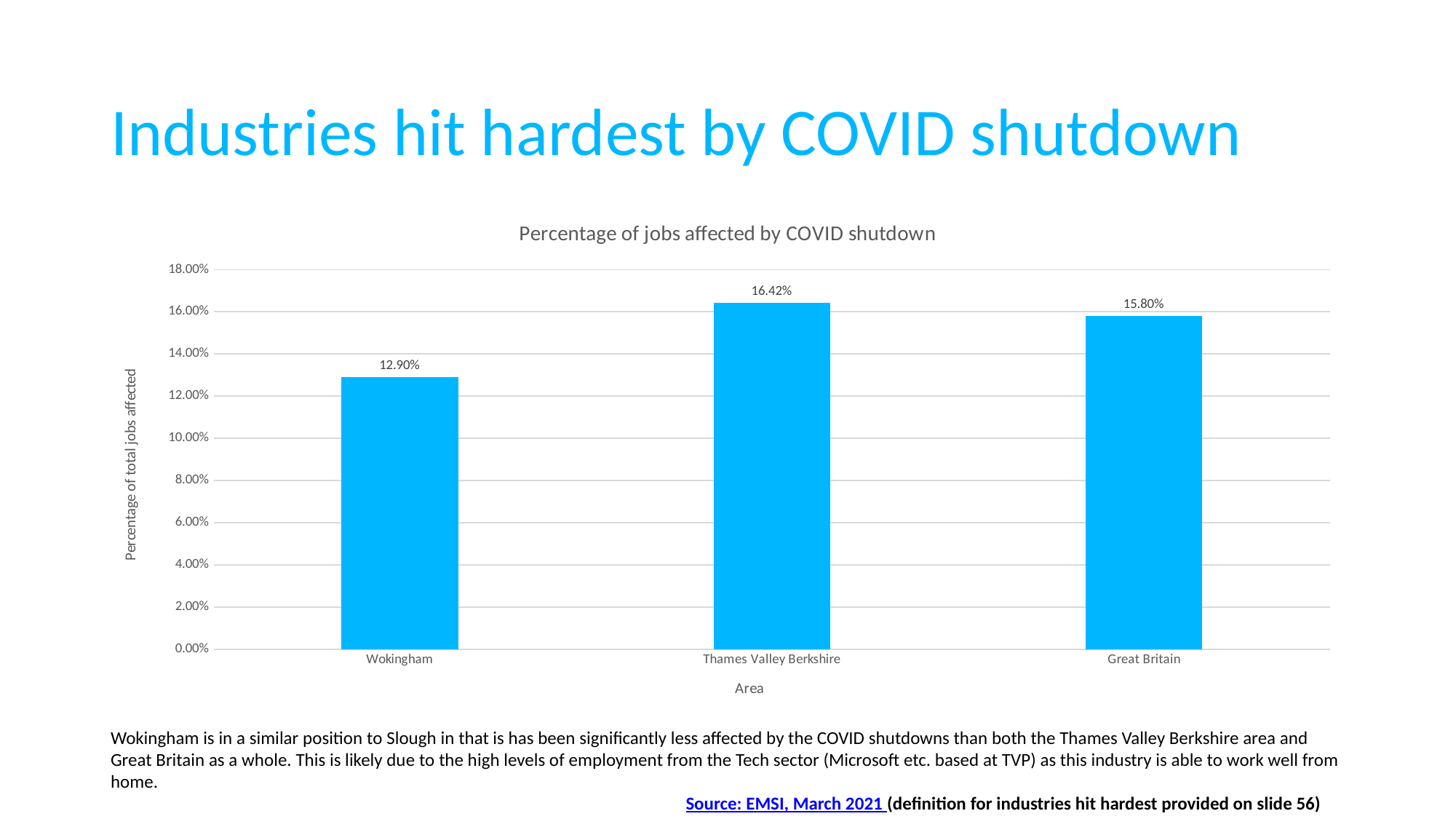
Which area has the lowest percentage of jobs affected by COVID shutdown? Wokingham What is the difference between the percentage of jobs affected in Great Britain and in Wokingham? 2.90% How many areas are shown in the chart? 3 What is the title of the chart? Percentage of jobs affected by COVID shutdown What is the percentage of jobs affected by COVID shutdown for Wokingham? 12.90% What is the percentage of jobs affected by COVID shutdown for Great Britain? 15.80% What kind of chart is shown on the slide? Bar chart What is the percentage of jobs affected by COVID shutdown for Thames Valley Berkshire? 16.42% What is the difference between the percentage of jobs affected in Thames Valley Berkshire and in Wokingham? 3.52% Is the value for Wokingham greater or less than 14.00%? less Which area has the highest percentage of jobs affected by COVID shutdown? Thames Valley Berkshire Which has a higher percentage of jobs affected by COVID shutdown, Great Britain or Wokingham? Great Britain